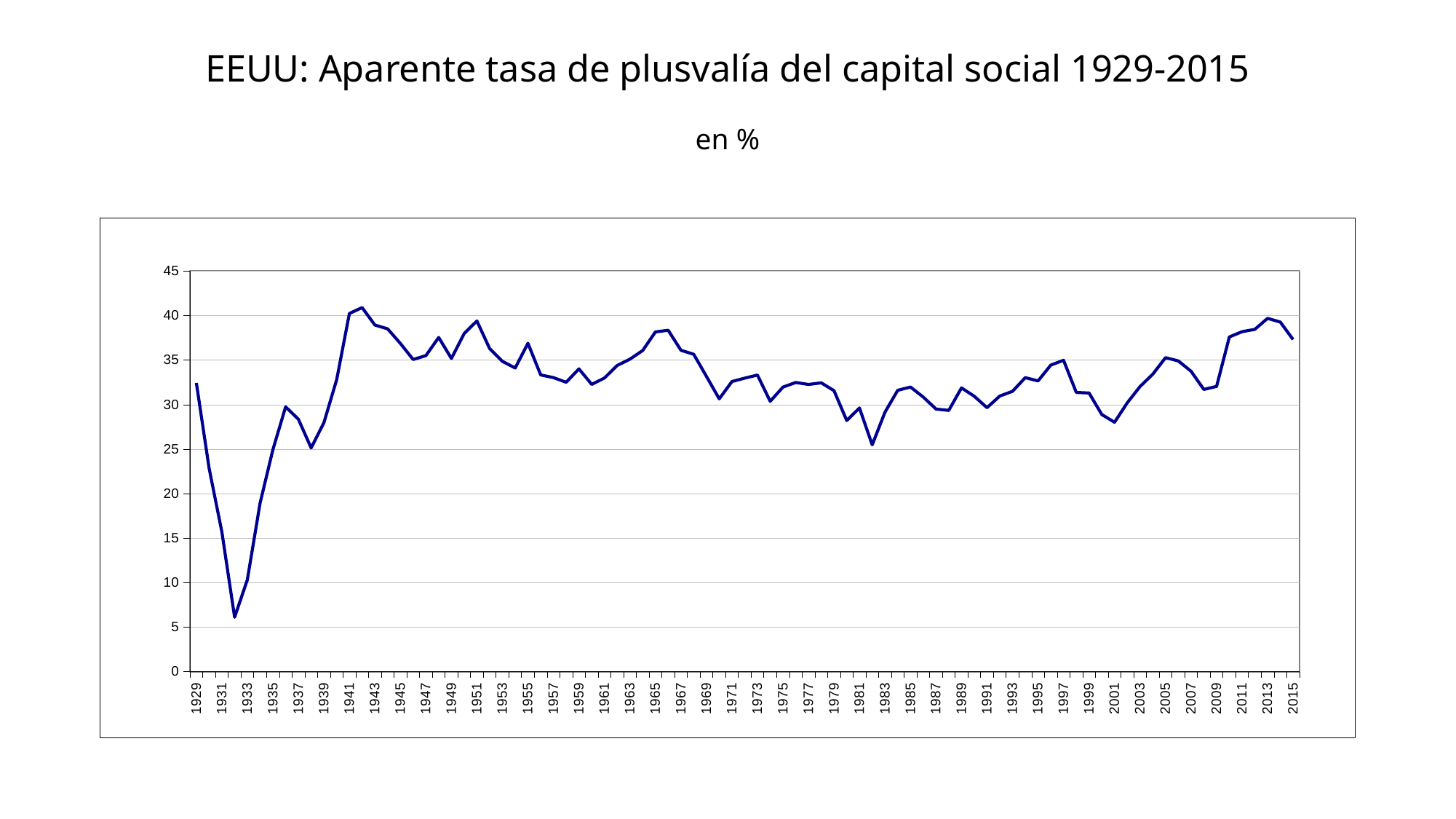
Which year has the lowest value on the chart? 1932 Is the value for 2001 greater or less than 30? less What kind of chart is shown on the slide? line chart Is the value for 2015 greater or less than 35? greater Which is larger, the value for 1942 or the value for 1982? 1942 What is the title of the chart? EEUU: Aparente tasa de plusvalía del capital social 1929-2015 Is the value for 1929 greater or less than 30? greater In what unit are the values expressed, according to the subtitle? en % Does the value rise or fall between 1929 and 1932? fall